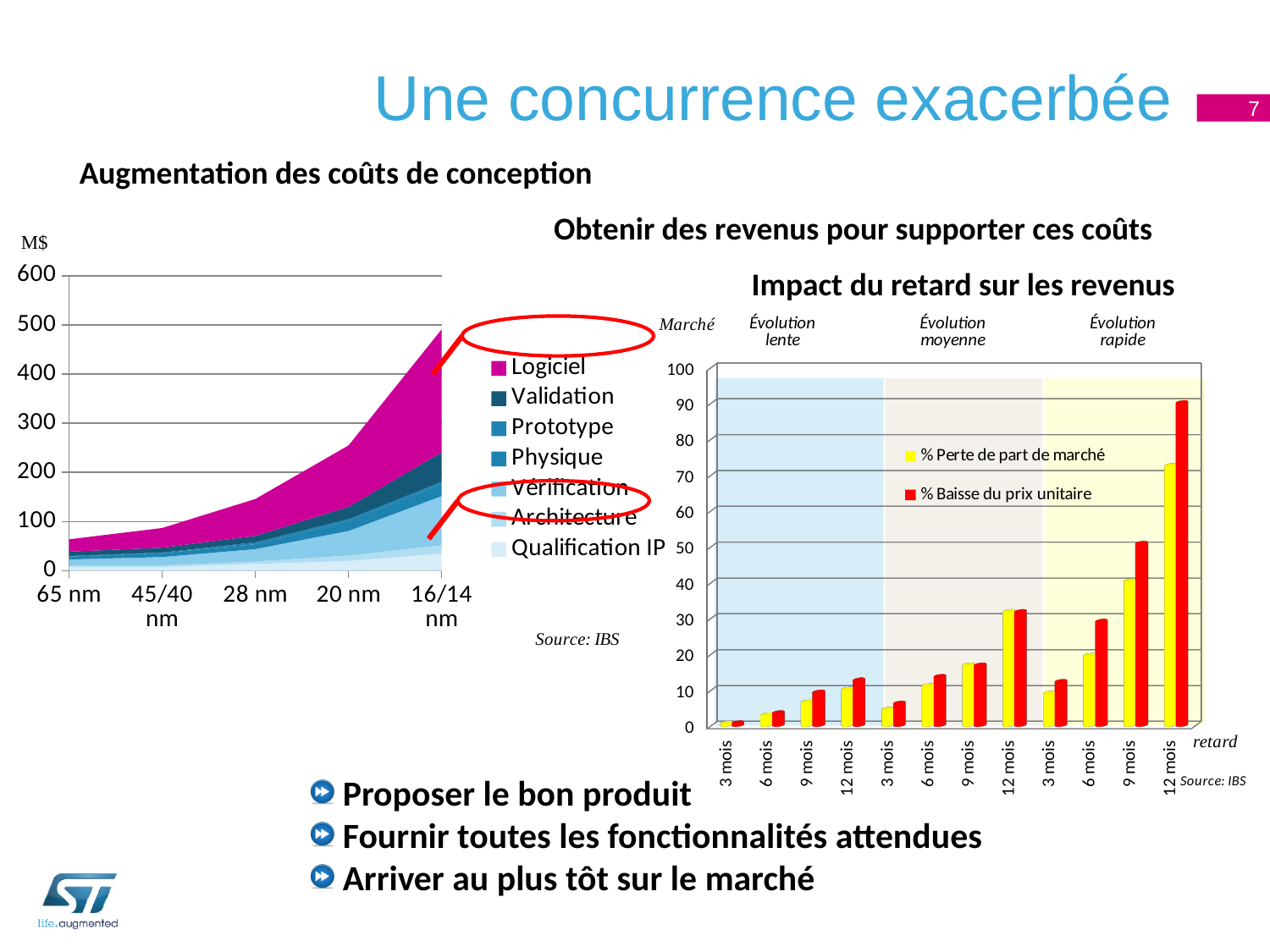
In the left chart (M$ by node), is the total design cost at 16/14 nm greater or less than 400? greater What kind of chart is the left chart showing design costs in M$ by technology node? stacked area chart In the left chart (M$ by node), do total design costs rise or fall from 65 nm to 16/14 nm? rise In the left chart (M$ by node), is the total design cost at 65 nm greater or less than 100? less How many series does the legend of 'Impact du retard sur les revenus' list? 2 How many series does the legend of the left chart (M$ by node) list? 7 In the left chart (M$ by node), which technology node has the highest total design cost? 16/14 nm In the left chart (M$ by node), which series is shown at the top of the stack in magenta? Logiciel In 'Impact du retard sur les revenus', is the '% Baisse du prix unitaire' value at 12 mois under Évolution rapide greater or less than 80? greater What kind of chart is 'Impact du retard sur les revenus'? bar chart How many technology nodes are shown on the x axis of the left chart (M$ by node)? 5 In the left chart (M$ by node), which technology node has the lowest total design cost? 65 nm